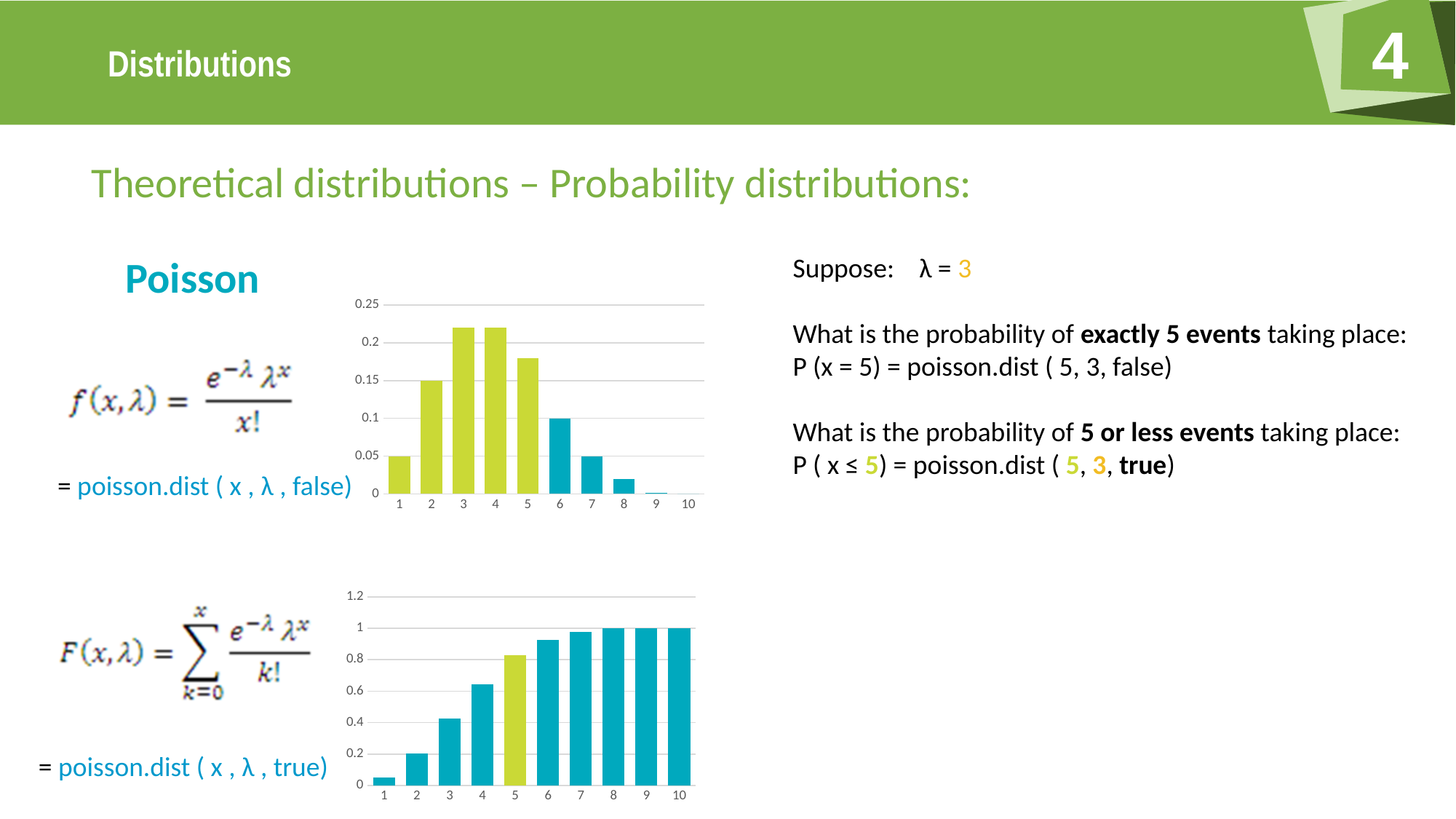
In the bottom chart, which bar is coloured differently (green) from the others? category 5 In the bottom chart, is the value for category 4 greater or less than 0.6? greater In the top chart, what is the value for category 6? 0.1 What kind of chart is the top chart on the slide? bar chart In the bottom chart, what is the value for category 2? 0.2 In the top chart, what is the value for category 1? 0.05 How many categories are shown on the x axis of the bottom chart? 10 In the bottom chart, which category has the lowest value? 1 In the top chart, which is larger, the value for category 2 or the value for category 6? category 2 In the top chart, is the value for category 5 greater or less than 0.15? greater In the bottom chart, what is the value for category 10? 1 In the bottom chart, do the values rise or fall as you move from category 1 to category 10? rise